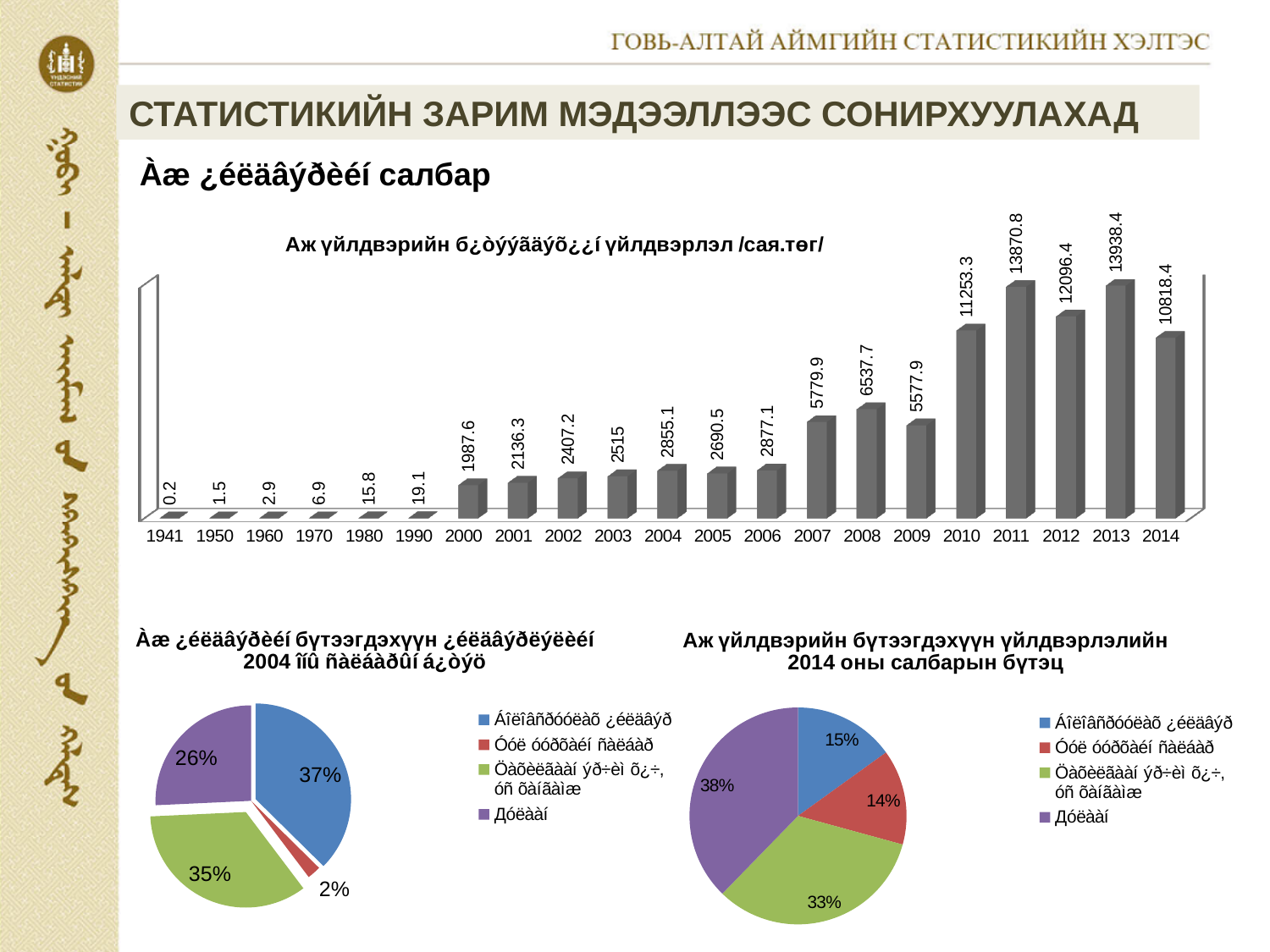
In the bar chart at the top of the slide, do the values rise or fall from 2000 to 2004? rise In the right pie chart (2014), what share does the purple slice have? 38% In the left pie chart (2004), what share does the largest slice have? 37% In the bar chart at the top of the slide, what is the value for 2000? 1987.6 How many entries does the legend of the right pie chart (2014) list? 4 What kind of chart is the chart at the top of the slide? bar chart In the bar chart at the top of the slide, which year has the lowest value? 1941 In the bar chart at the top of the slide, which year has the highest value? 2013 In the bar chart at the top of the slide, what is the difference between the values for 2011 and 2010? 2617.5 How many years are shown on the x axis of the bar chart at the top of the slide? 21 In the bar chart at the top of the slide, what is the value for 2014? 10818.4 In the bar chart at the top of the slide, which is larger, the value for 2008 or the value for 2009? 2008